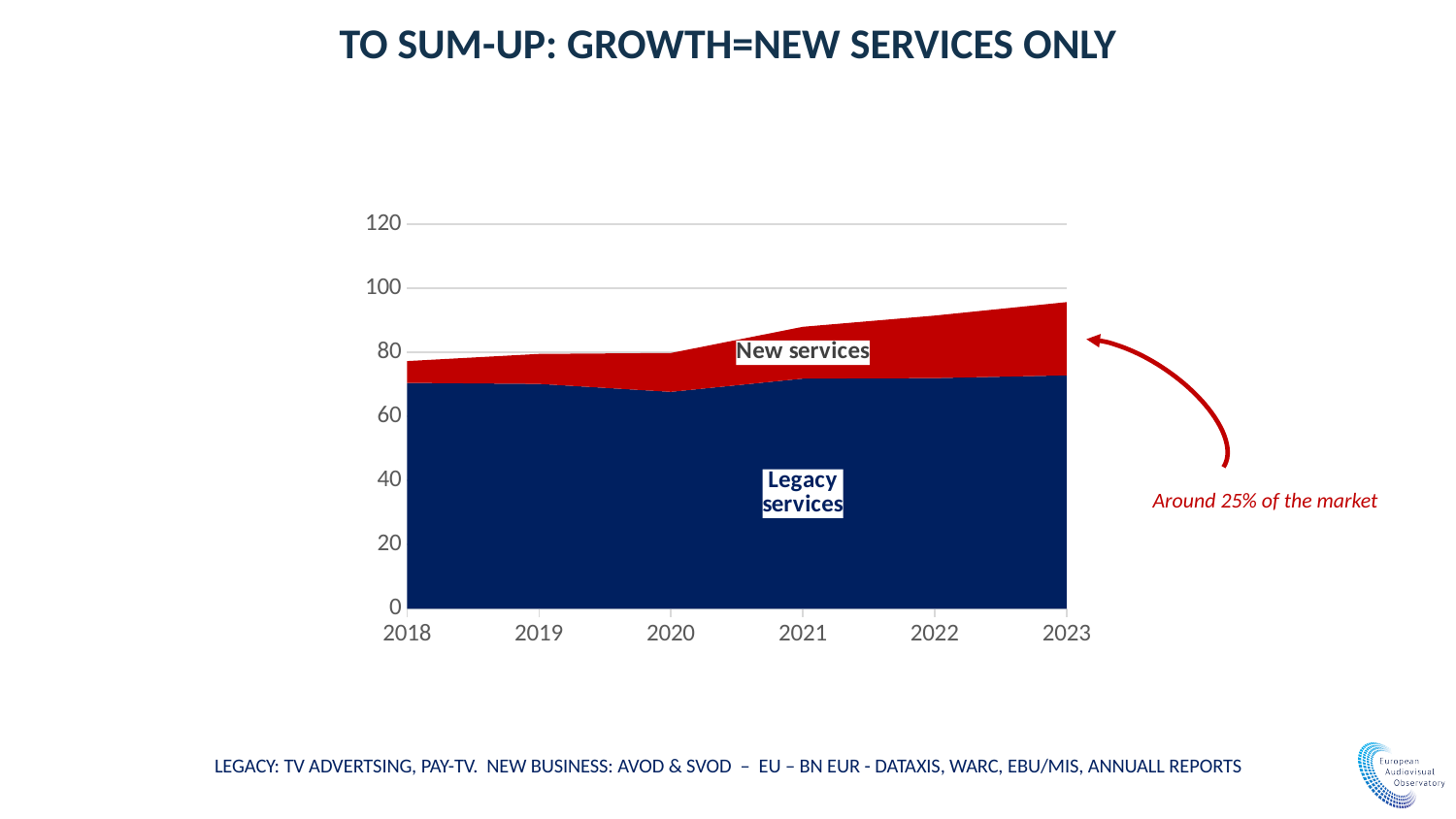
Is the value for Legacy services in 2020 greater or less than 60? greater Is the total value for 2021 greater or less than 80? greater According to the annotation, what share of the market do new services represent in 2023? Around 25% of the market What kind of chart is shown on the slide? Stacked area chart What is the first year shown on the x axis? 2018 Is the value for Legacy services in 2023 greater or less than 80? less How many years are shown on the x axis of the chart? 6 Which series is stacked on top in the chart? New services How many series does the chart show? 2 Does the total (Legacy services plus New services) rise or fall from 2018 to 2023? Rises